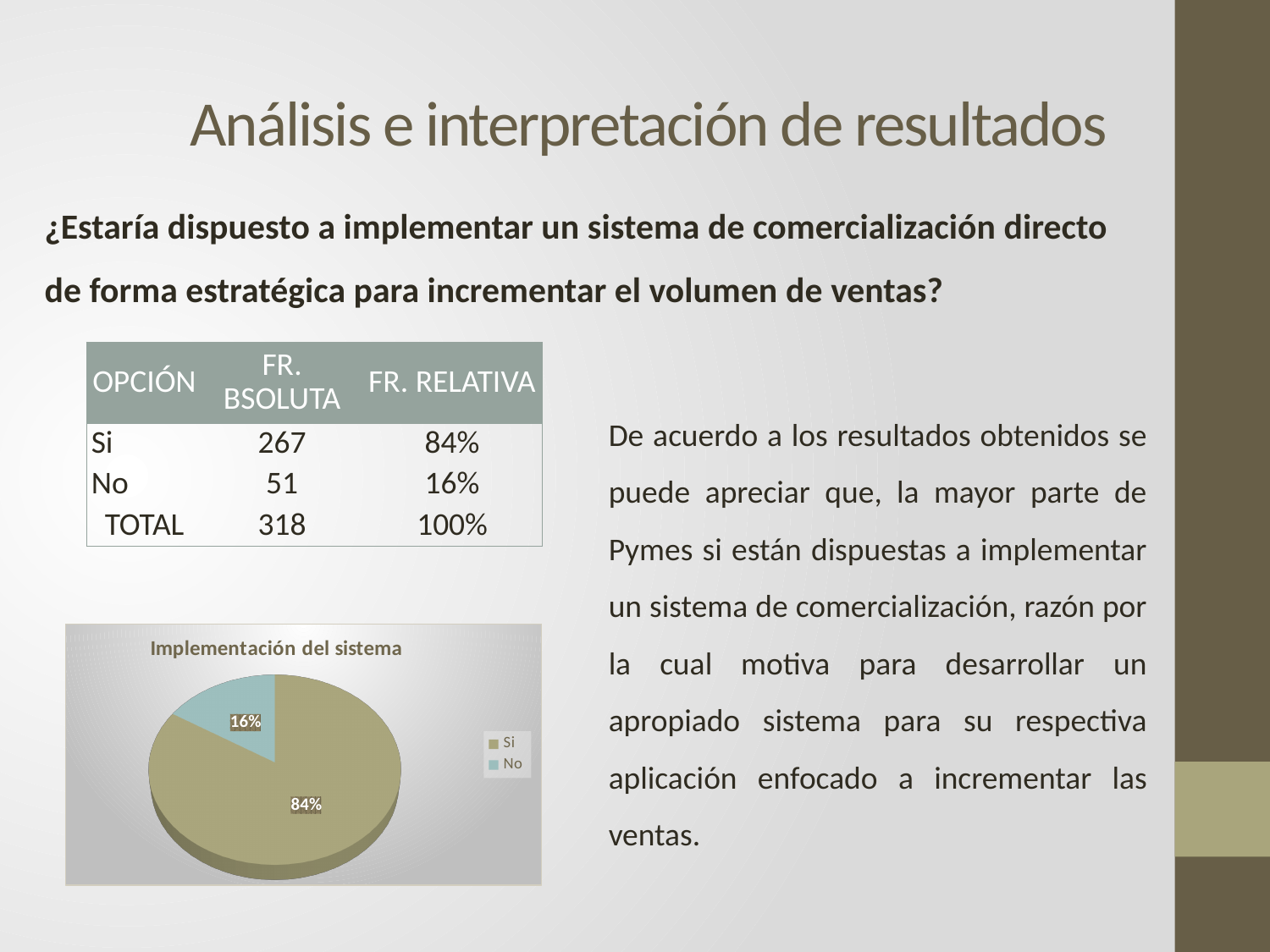
What share of the pie does the 'No' slice represent? 16% Which slice of the pie is the smallest? No What is the difference in percentage points between the 'Si' and 'No' slices? 68% How many slices does the pie chart have? 2 Which slice of the pie is the largest? Si Which slice is larger, 'Si' or 'No'? Si How many entries does the chart legend list? 2 What kind of chart is shown on the slide? Pie chart Which legend entry is shown in the light blue colour? No What share of the pie does the 'Si' slice represent? 84% What is the title of the chart? Implementación del sistema